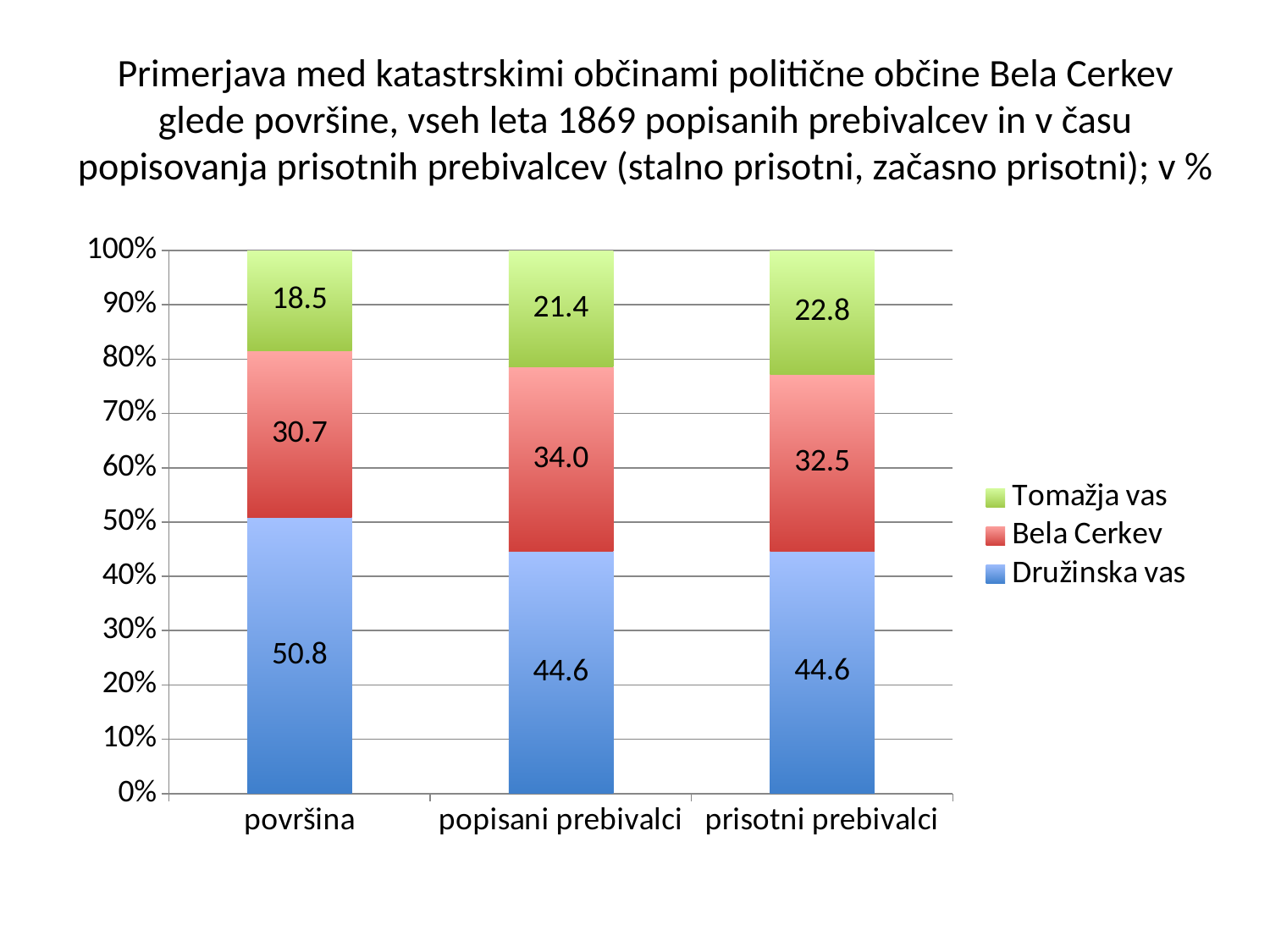
What kind of chart is shown on the slide? stacked bar chart In which category is the value for Tomažja vas highest? prisotni prebivalci What is the difference between the Družinska vas value for površina and for popisani prebivalci? 6.2 How many categories are shown on the x axis? 3 What is the value for Bela Cerkev in the popisani prebivalci category? 34.0 Which is larger: the Bela Cerkev value for popisani prebivalci or for prisotni prebivalci? popisani prebivalci What is the value for Tomažja vas in the prisotni prebivalci category? 22.8 Does the value for Tomažja vas rise or fall across the categories from površina to prisotni prebivalci? rise Which colour represents Družinska vas in the chart? blue How many series does the legend list? 3 In which category is the value for Bela Cerkev lowest? površina What is the value for Družinska vas in the površina category? 50.8